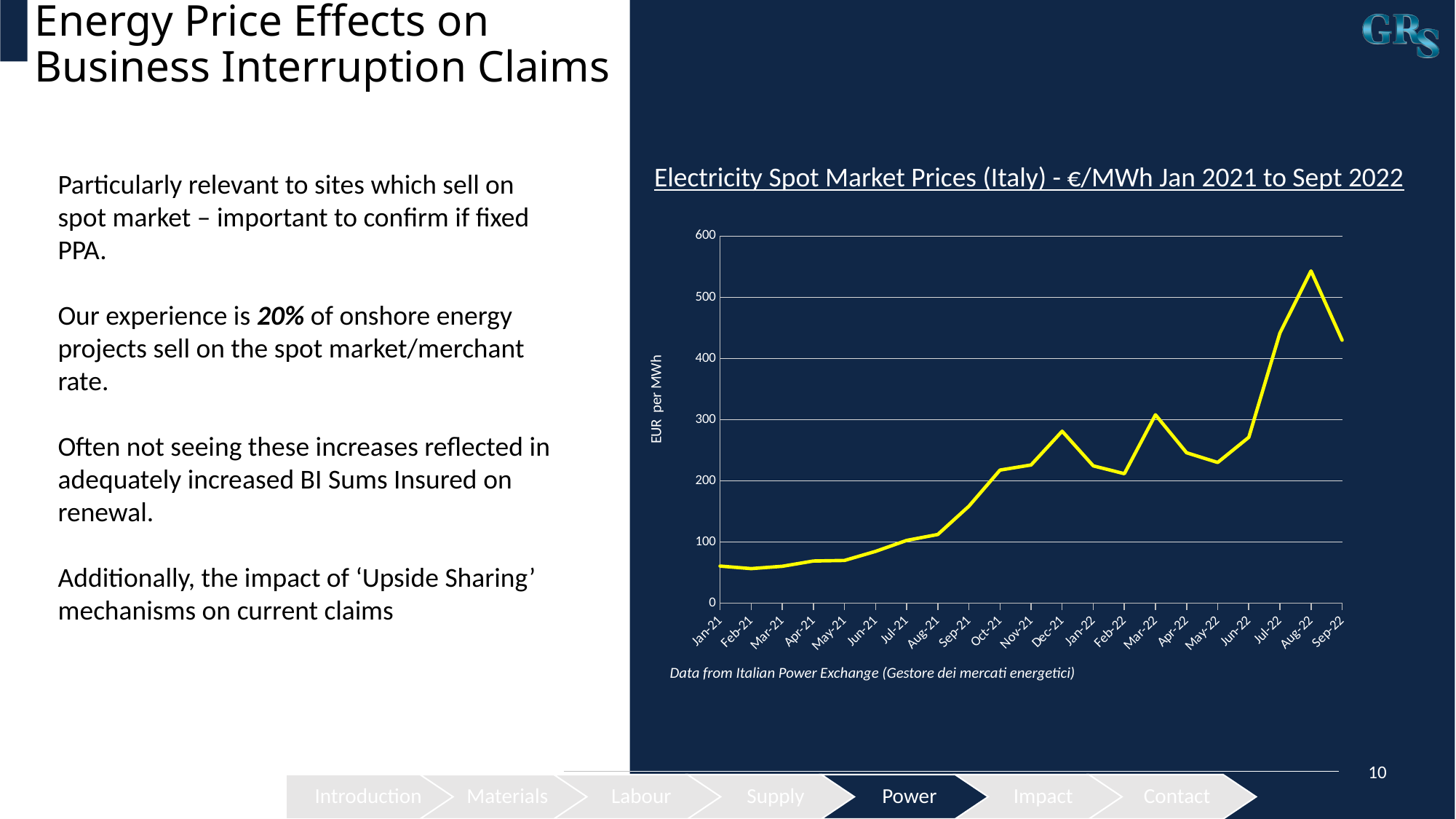
What is the title of the chart? Electricity Spot Market Prices (Italy) - €/MWh Jan 2021 to Sept 2022 Is the value for Aug-22 greater or less than 500? greater Is the value for Oct-21 greater or less than 200? greater Is the value for Jan-21 greater or less than 100? less What is the label on the vertical axis of the chart? EUR per MWh Which is larger, the value for Aug-22 or the value for Dec-21? Aug-22 Which month has the highest electricity spot price in the chart? Aug-22 How many months are plotted along the x axis of the chart? 21 What kind of chart is shown on the slide? Line chart Overall, do electricity spot prices rise or fall from Jan-21 to Sep-22? Rise